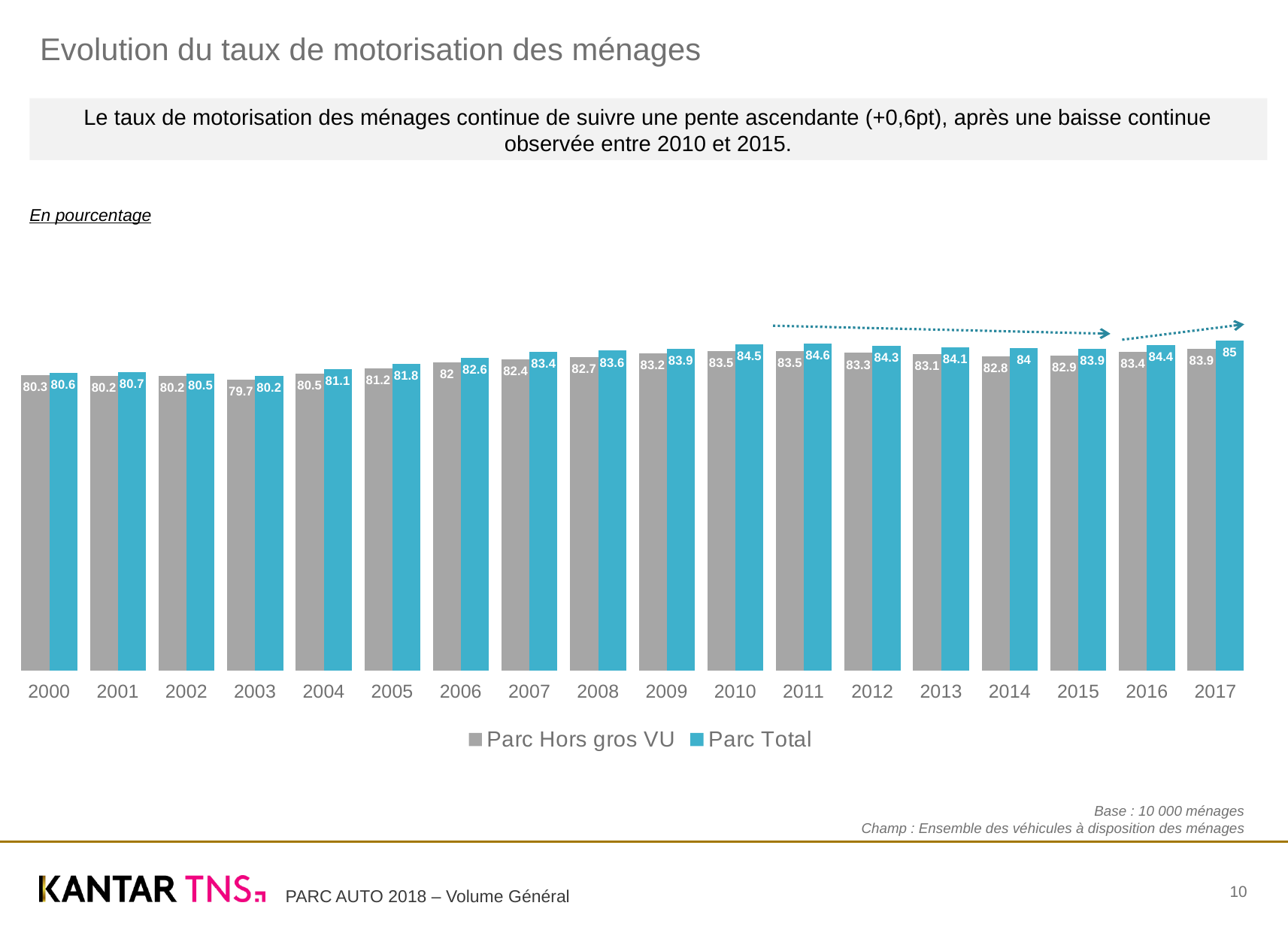
What is the value of Parc Total for 2010? 84.5 Which is larger, Parc Total in 2009 or Parc Total in 2014? Parc Total in 2014 What is the difference between Parc Total and Parc Hors gros VU in 2017? 1.1 Which colour represents the Parc Total series? Blue How many series does the legend list? 2 In which year is Parc Hors gros VU the lowest? 2003 What is the value of Parc Total for 2017? 85 How many years are shown on the x axis? 18 What is the value of Parc Hors gros VU for 2003? 79.7 What kind of chart is shown on the slide? Bar chart What is the difference between the Parc Total value in 2011 and in 2015? 0.7 In which year is Parc Total the highest? 2017